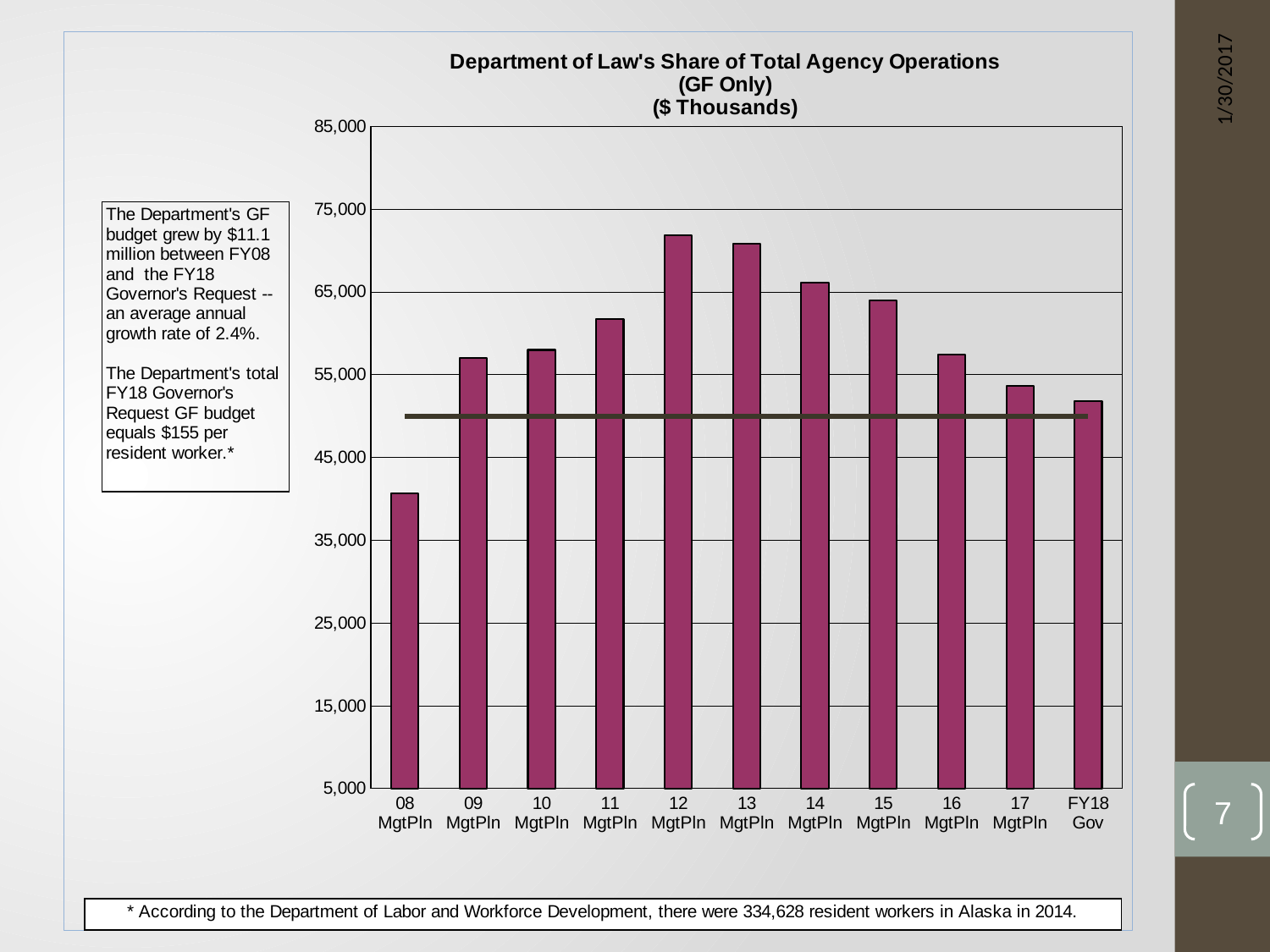
Which category has the highest bar? 12 MgtPln Do the values rise or fall from 12 MgtPln through FY18 Gov? fall How many bars are plotted in the chart? 11 Is the value for 08 MgtPln greater or less than 45,000? less Is the value for FY18 Gov greater or less than 55,000? less Which is larger, the value for 08 MgtPln or the value for 09 MgtPln? 09 MgtPln What kind of chart is shown on the slide? bar chart Is the value for 14 MgtPln greater or less than 65,000? greater Which category has the lowest bar? 08 MgtPln Which is larger, the value for 13 MgtPln or the value for 17 MgtPln? 13 MgtPln What is the title of the chart? Department of Law's Share of Total Agency Operations (GF Only) ($ Thousands)